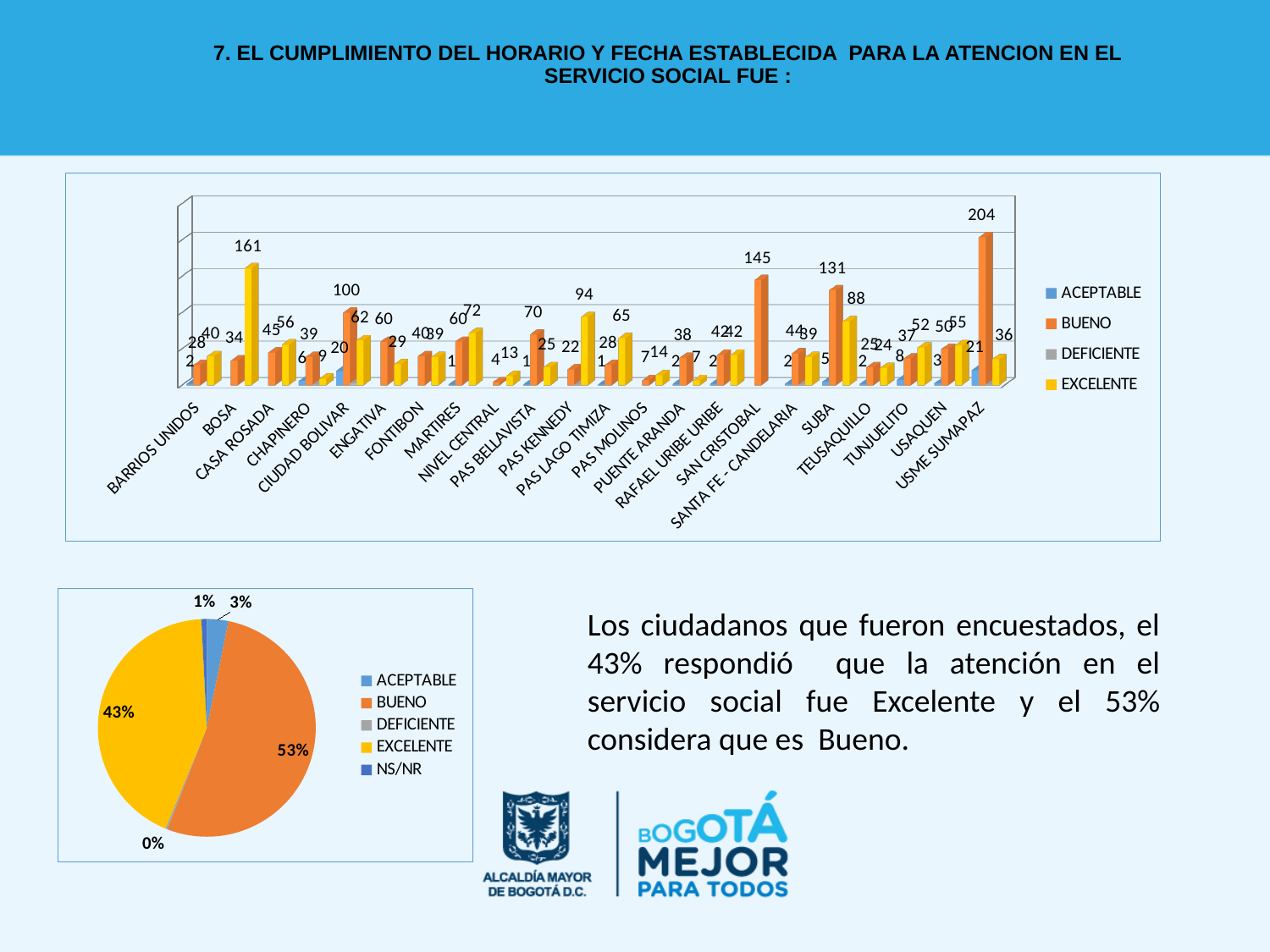
How many series does the legend of the top bar chart list? 4 What kind of chart is the chart at the bottom left of the slide? Pie chart In the top bar chart, what is the BUENO value for USME SUMAPAZ? 204 In the top bar chart, which category has the highest single bar? USME SUMAPAZ In the top bar chart, what is the BUENO value for SAN CRISTOBAL? 145 In the pie chart, which category has the largest slice? BUENO In the top bar chart, what is the difference between the BUENO value for USME SUMAPAZ and the EXCELENTE value for BOSA? 43 How many series does the legend of the pie chart list? 5 In the pie chart, what share does BUENO have? 53% In the top bar chart, what is the EXCELENTE value for BOSA? 161 In the top bar chart, which is larger: the BUENO value for USME SUMAPAZ or the EXCELENTE value for BOSA? BUENO for USME SUMAPAZ How many categories are shown on the x axis of the top bar chart? 22